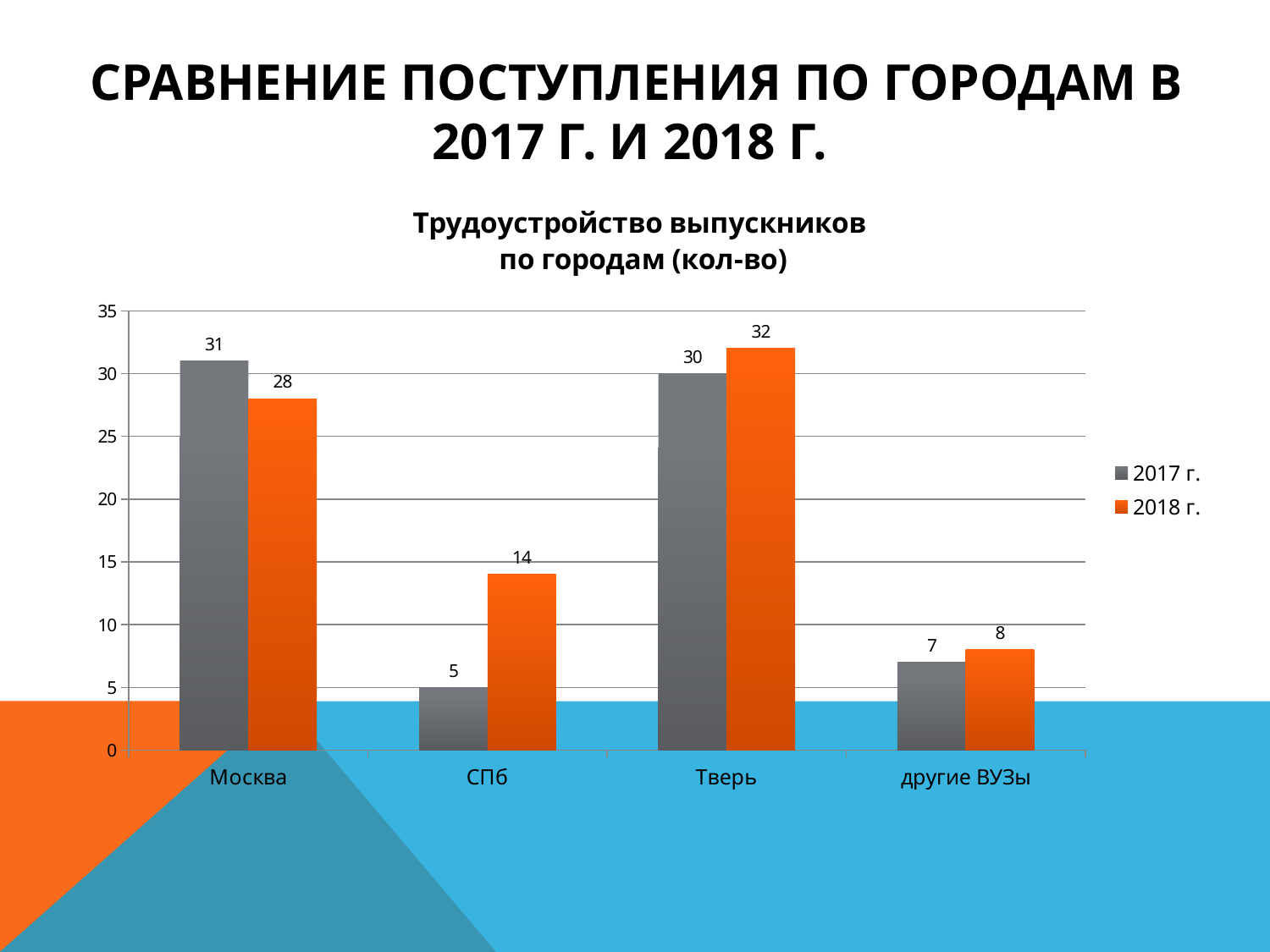
What kind of chart is shown on the slide? Bar chart Which category has the highest value in the 2018 г. series? Тверь What is the value for другие ВУЗы in the 2017 г. series? 7 Which category has the lowest value in the 2017 г. series? СПб What is the value for Тверь in the 2018 г. series? 32 How many categories are shown on the x axis? 4 What is the title of the chart? Трудоустройство выпускников по городам (кол-во) What is the value for СПб in the 2018 г. series? 14 What is the value for Москва in the 2017 г. series? 31 Which is larger for Москва: the 2017 г. value or the 2018 г. value? 2017 г. How many series does the legend list? 2 What is the difference between the 2018 г. and 2017 г. values for СПб? 9